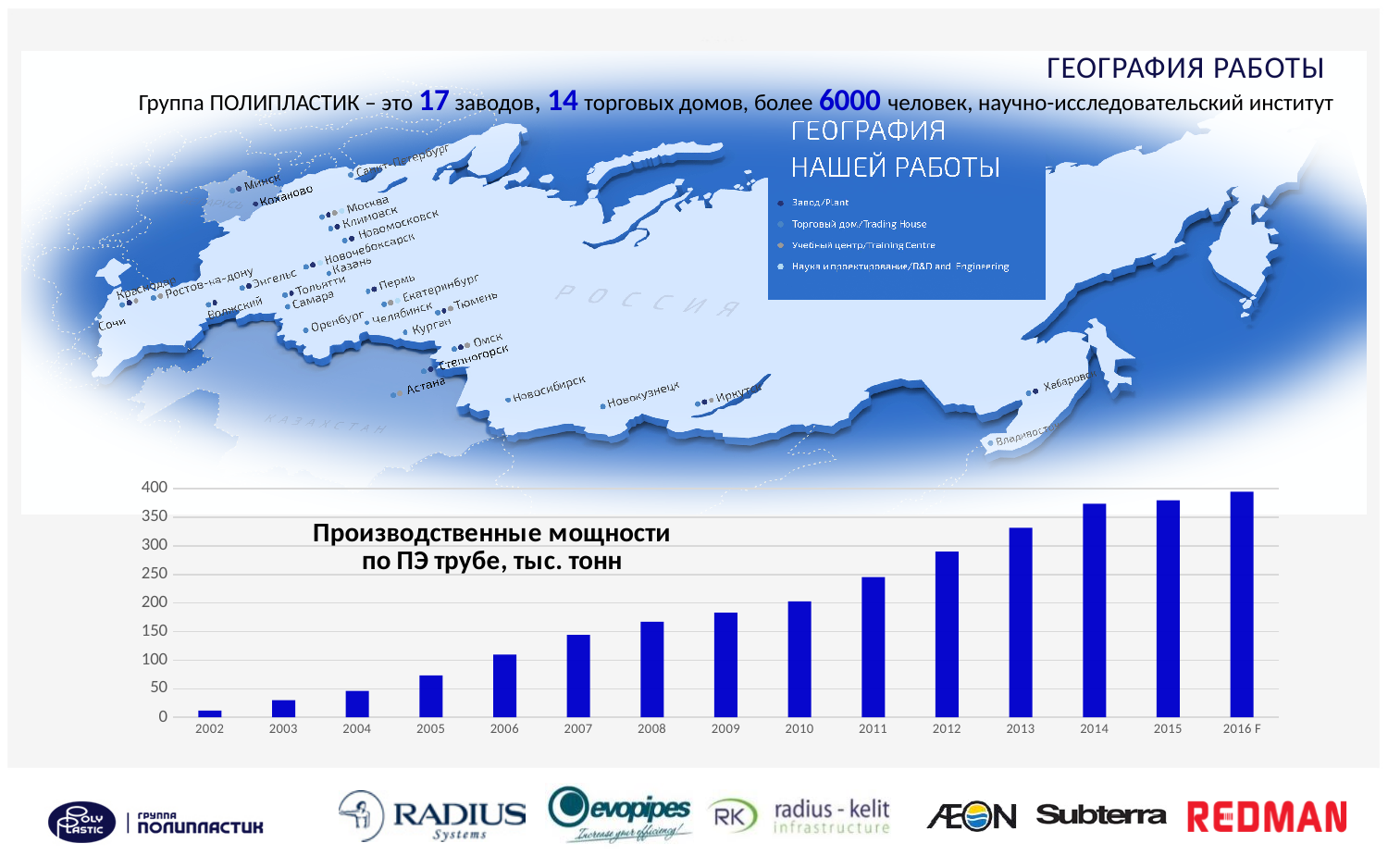
Do the values on the chart 'Производственные мощности по ПЭ трубе' rise or fall from 2002 to 2016 F? rise What is the highest value shown on the vertical axis of the bar chart? 400 What is the title of the bar chart on the slide? Производственные мощности по ПЭ трубе, тыс. тонн On the chart 'Производственные мощности по ПЭ трубе', which is larger: the value for 2009 or the value for 2011? 2011 Is the value for 2003 on the chart 'Производственные мощности по ПЭ трубе' greater or less than 50? less Which year has the lowest value on the chart 'Производственные мощности по ПЭ трубе'? 2002 What kind of chart is shown at the bottom of the slide? bar chart Is the value for 2006 on the chart 'Производственные мощности по ПЭ трубе' greater or less than 150? less How many years (bars) are shown on the chart 'Производственные мощности по ПЭ трубе, тыс. тонн'? 15 Which year has the highest value on the chart 'Производственные мощности по ПЭ трубе'? 2016 F Is the value for 2016 F on the chart 'Производственные мощности по ПЭ трубе' greater or less than 350? greater